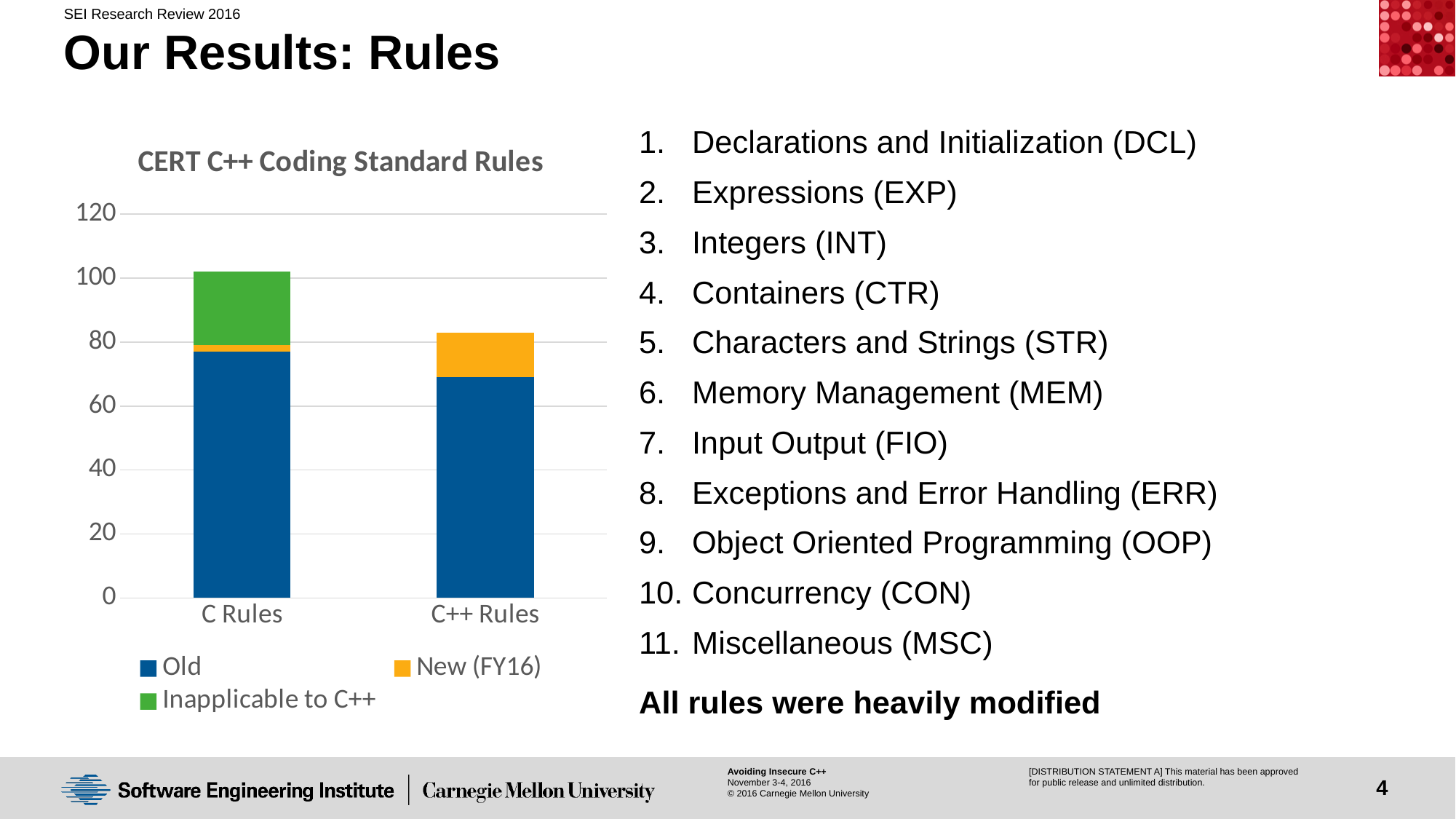
Which category has the taller stacked bar, C Rules or C++ Rules? C Rules Which series in the chart is shown in green? Inapplicable to C++ Is the total height of the C++ Rules bar greater or less than 100? less Is the total height of the C Rules bar greater or less than 80? greater Is the Old segment for C Rules greater or less than 60? greater How many series does the chart legend list? 3 How many categories are shown on the x axis of the chart? 2 What kind of chart is shown on the slide? stacked bar chart What is the title of the chart? CERT C++ Coding Standard Rules Which category has the larger Old segment, C Rules or C++ Rules? C Rules